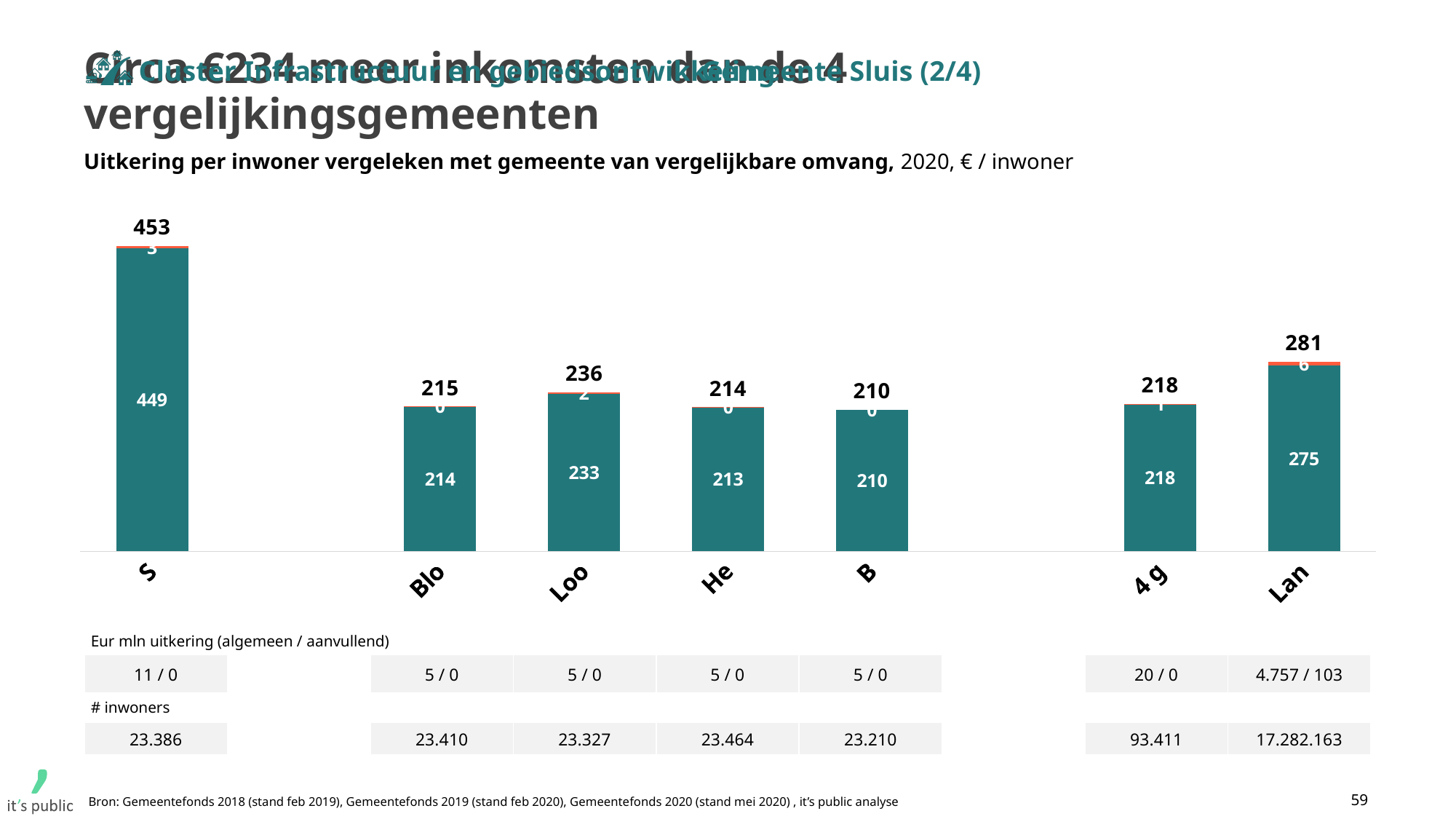
Which has a larger total, Lan or Loo? Lan How many bars are plotted in the chart? 7 Which category has the lowest total value? B What is the difference between the total for Blo and the total for He? 1 What is the total value shown above the bar for S? 453 What is the total value shown above the bar for 4 g? 218 What is the total value shown above the bar for Lan? 281 What unit is stated in the chart subtitle for the plotted values? € / inwoner Which category has the highest total value? S What is the value of the teal segment of the bar for Loo? 233 What kind of chart is shown on the slide? Stacked bar chart What is the difference between the total for S and the total for Loo? 217